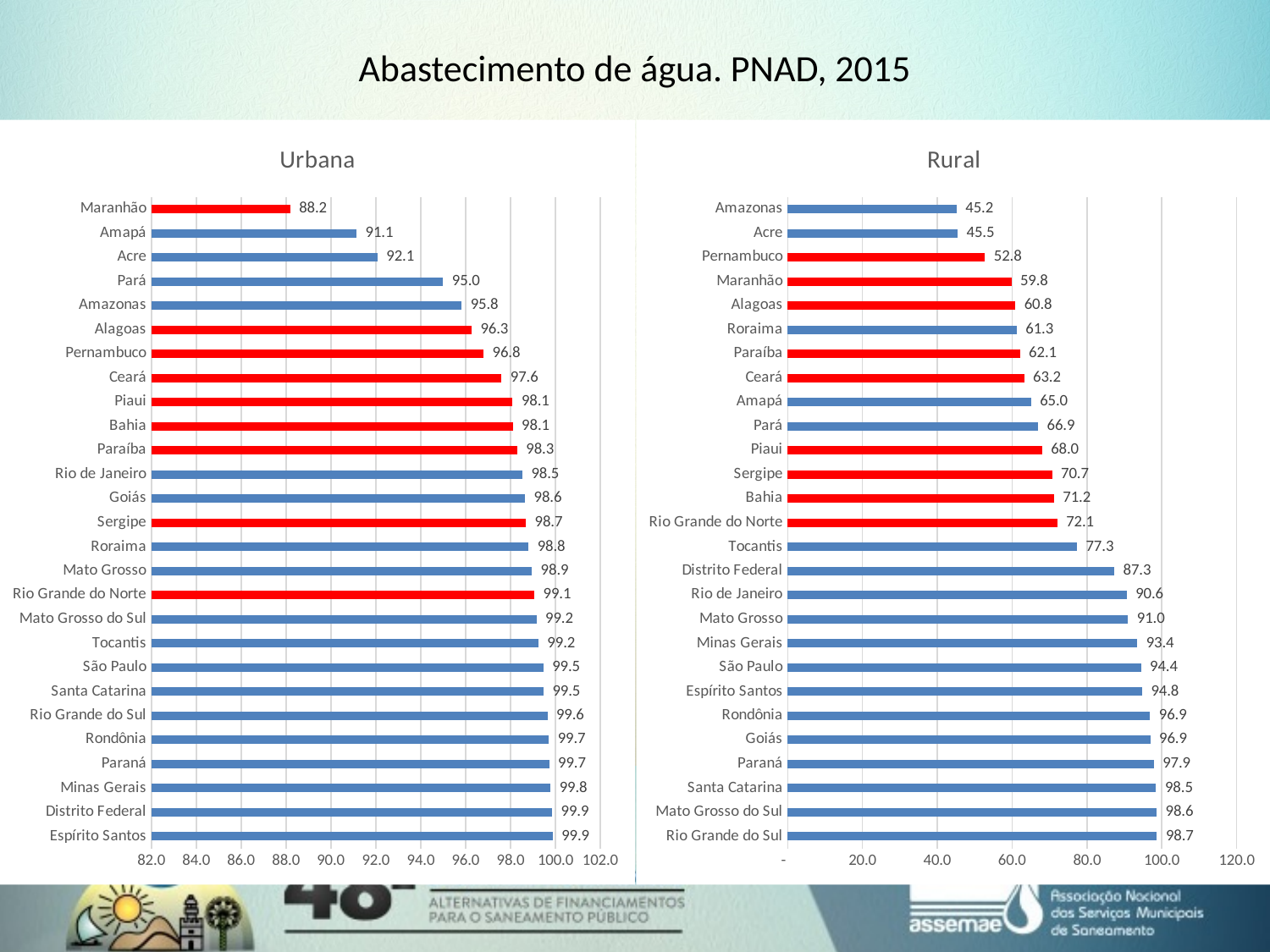
On the Rural chart, what is the value for Pernambuco? 52.8 On the Rural chart, what is the value for Tocantis? 77.3 On the Rural chart, which has the larger value, Maranhão or Pará? Pará On the Rural chart, what is the difference between the values for Pernambuco and Amazonas? 7.6 On the Urbana chart, which state has the lowest value? Maranhão What is the title of the chart on the right side of the slide? Rural On the Urbana chart, what is the value for Maranhão? 88.2 On the Rural chart, is the value for Amazonas greater or less than 60.0? less What kind of chart is the Urbana chart? bar chart On the Urbana chart, what is the difference between the values for Amapá and Maranhão? 2.9 How many states are listed on the Rural chart? 27 On the Urbana chart, what colour is the bar for Maranhão? red